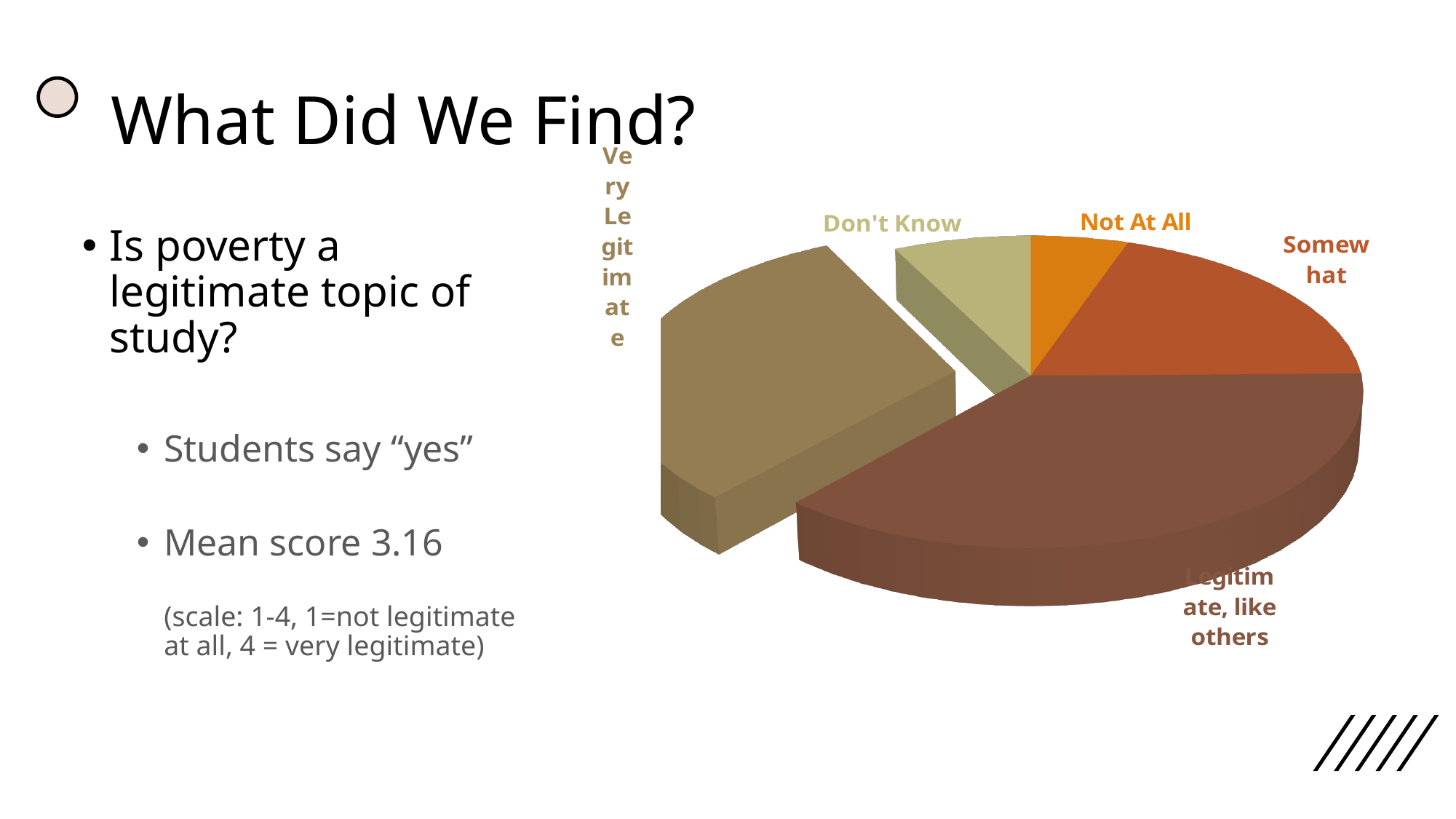
Which slice is larger, Somewhat or Not At All? Somewhat Which slice is larger, Don't Know or Not At All? Don't Know How many slices does the pie chart have? 5 Which slices of the pie chart are pulled out (exploded) from the rest of the pie? Very Legitimate and Don't Know Which category has the smallest slice of the pie chart? Not At All Which category has the largest slice of the pie chart? Legitimate, like others Which slice is larger, Very Legitimate or Don't Know? Very Legitimate What kind of chart is shown on the slide? pie chart Which slice of the pie chart is coloured orange? Not At All